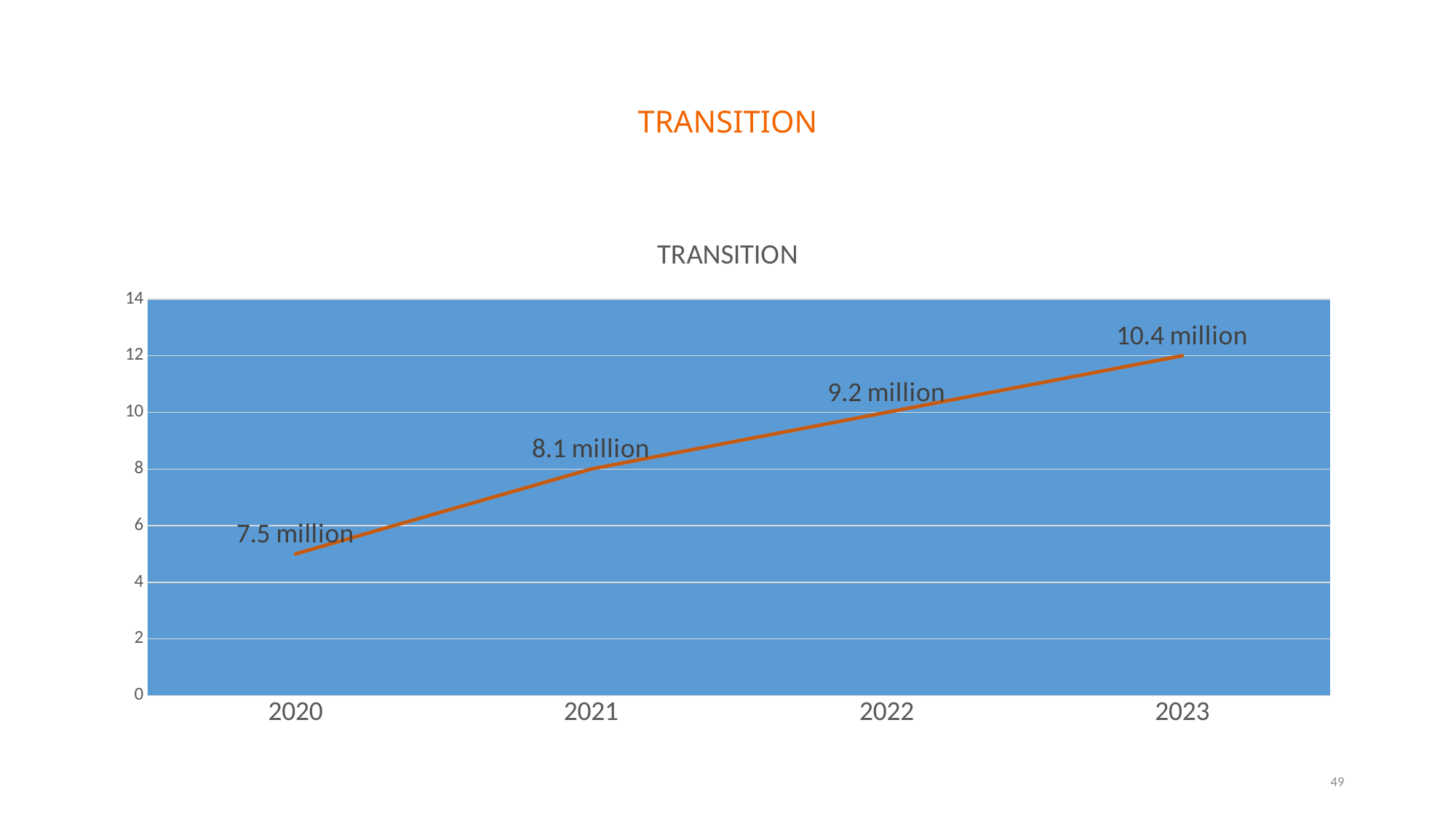
What is the value for 2020? 7.5 million Which year has the highest value? 2023 What is the value for 2022? 9.2 million How many years are plotted on the chart? 4 What is the difference between the values for 2023 and 2020? 2.9 million Which year has the lowest value? 2020 What is the value for 2021? 8.1 million What kind of chart is shown? line chart Which is larger, the value for 2021 or the value for 2022? 2022 Do the values rise or fall from 2020 to 2023? rise What is the value for 2023? 10.4 million What is the difference between the values for 2022 and 2021? 1.1 million